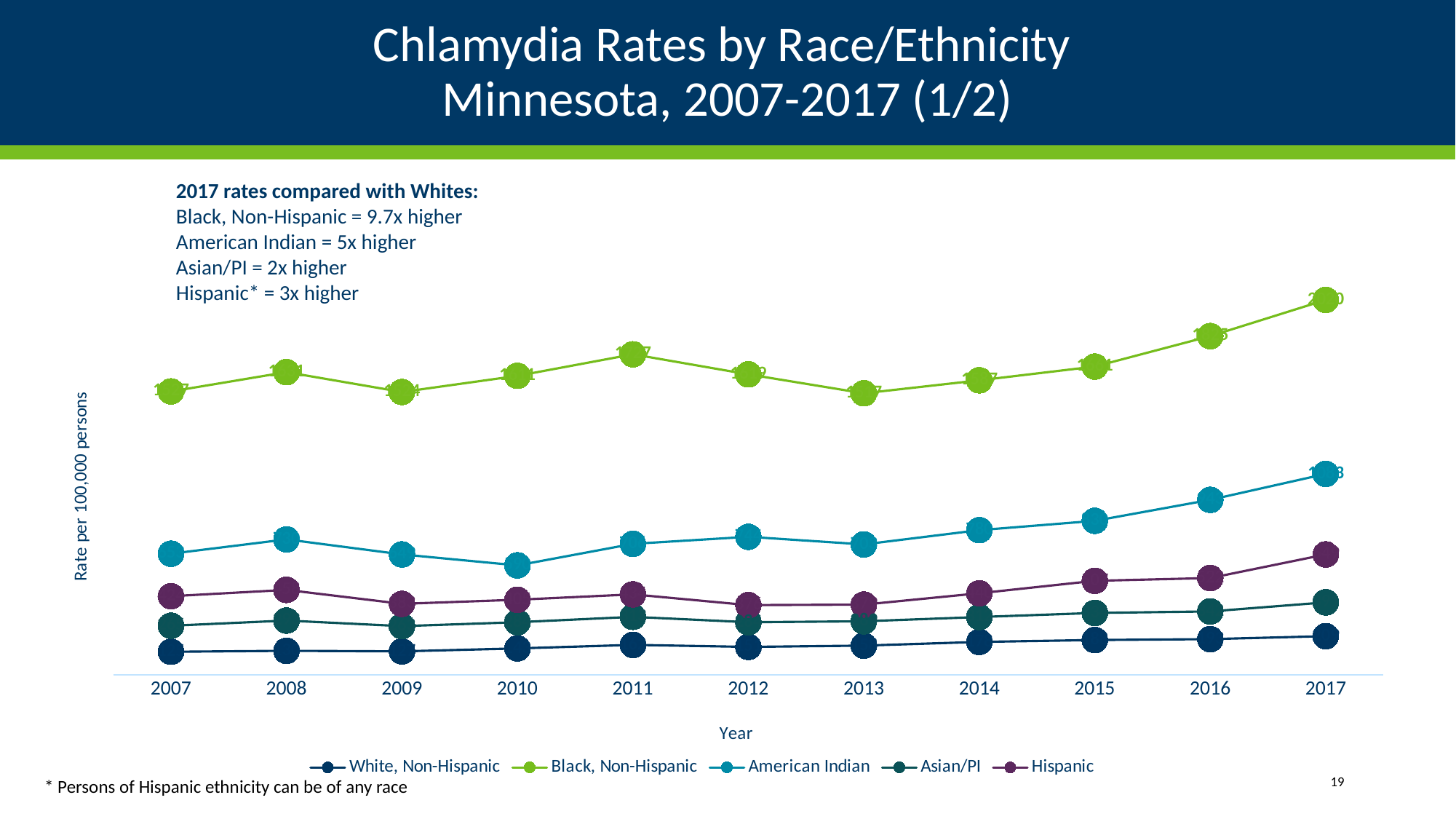
What is the label on the y axis? Rate per 100,000 persons Which race/ethnicity group has the lowest chlamydia rate in 2017? White, Non-Hispanic What kind of chart is shown on the slide? Line chart How many series does the legend list? 5 Which group has the second-highest rate across the years shown? American Indian In 2012, is the rate for American Indian higher or lower than the rate for Black, Non-Hispanic? Lower How many years are shown along the x axis? 11 In 2017, is the rate for Hispanic higher or lower than the rate for Asian/PI? Higher Does the American Indian rate rise or fall from 2014 to 2017? Rise Does the Black, Non-Hispanic rate rise or fall from 2013 to 2017? Rise According to the text on the slide, how many times higher than Whites was the 2017 rate for Black, Non-Hispanic? 9.7x higher Which race/ethnicity group has the highest chlamydia rate in 2017? Black, Non-Hispanic